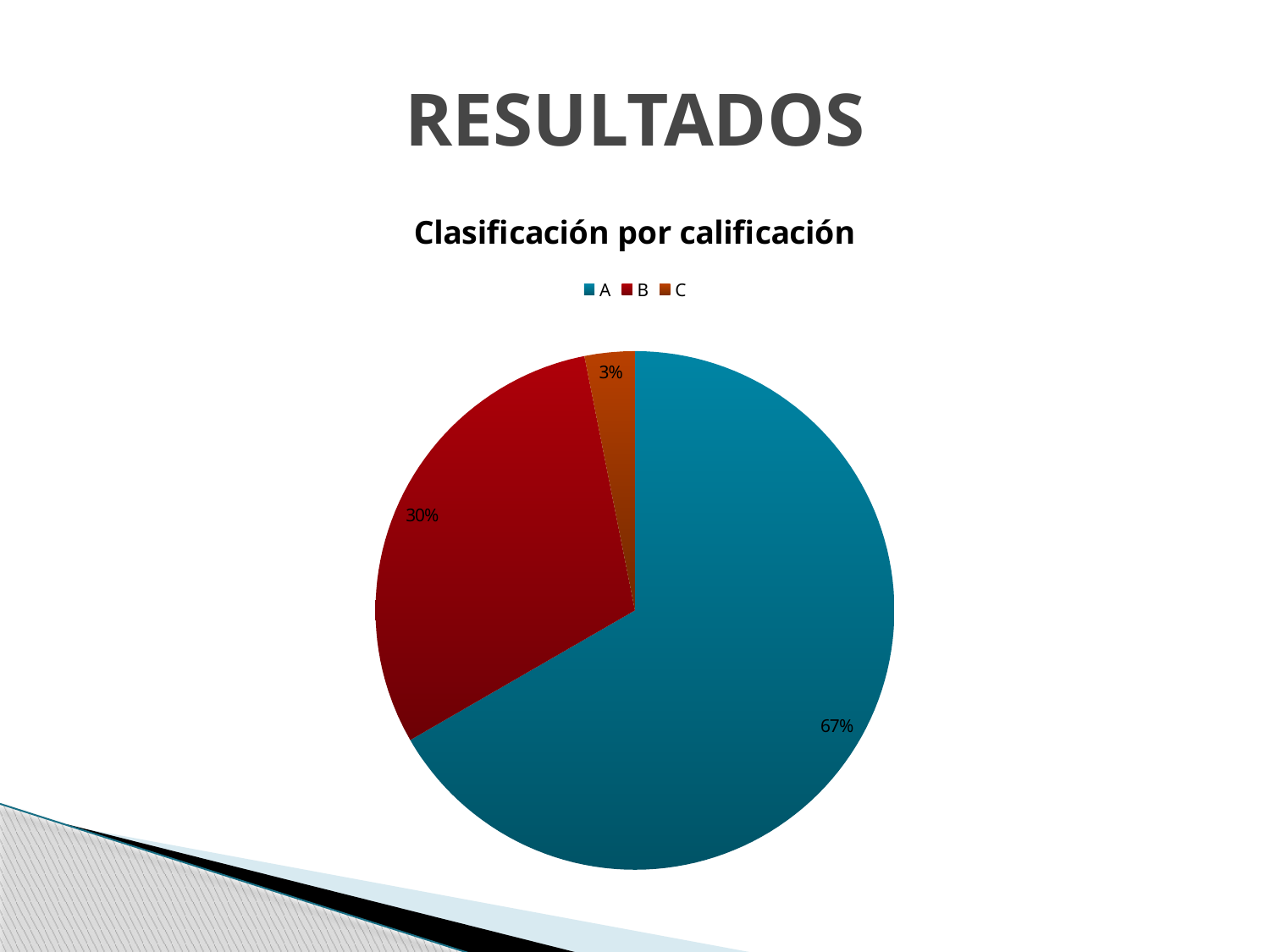
How many categories does the legend list? 3 What share of the pie does category C have? 3% What colour is the slice for category B? red Which is larger, the share of B or the share of C? B Which category has the largest slice of the pie? A What share of the pie does category A have? 67% Which category has the smallest slice of the pie? C What type of chart is shown on the slide? pie chart What share of the pie does category B have? 30% What is the title of the chart? Clasificación por calificación What is the difference in percentage points between the shares of A and B? 37 What is the combined share of B and C? 33%